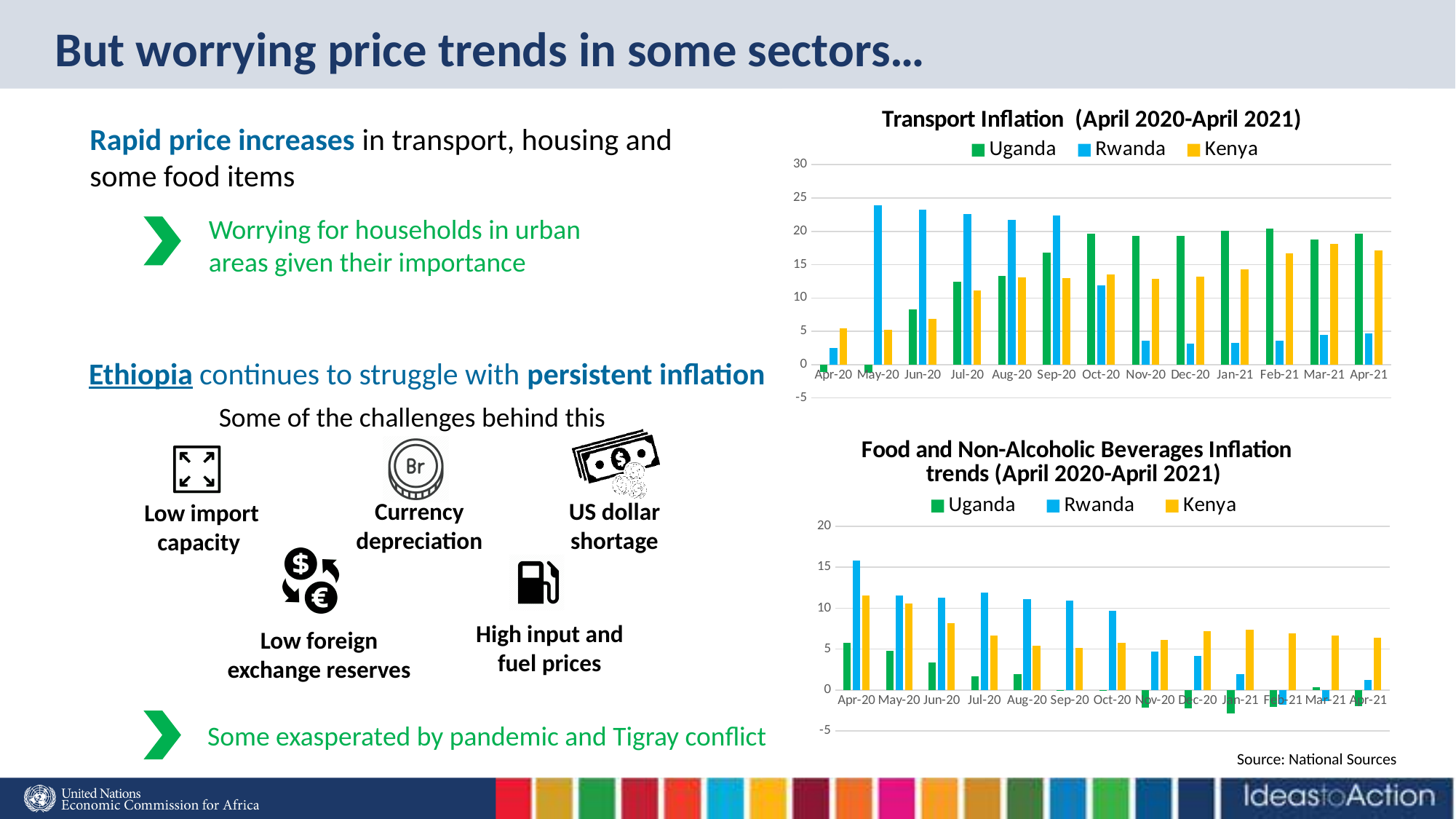
In the Transport Inflation chart, which is larger in Apr-21: Uganda or Rwanda? Uganda What kind of chart is the Transport Inflation (April 2020-April 2021) chart? Bar chart In the Food and Non-Alcoholic Beverages Inflation trends chart, is the value for Rwanda in Apr-20 greater or less than 15? greater How many months are shown on the x axis of the Transport Inflation chart? 13 How many series does the legend of the Transport Inflation chart list? 3 In the Transport Inflation chart, is the value for Rwanda in May-20 greater or less than 20? greater In the Transport Inflation chart, does the Rwanda value rise or fall from Sep-20 to Oct-20? Fall In the Transport Inflation chart, which country has the highest bar in May-20? Rwanda In the Food and Non-Alcoholic Beverages Inflation trends chart, which is larger in Apr-21: Kenya or Rwanda? Kenya In the Transport Inflation chart, is the value for Kenya in Apr-21 greater or less than 15? greater In the Food and Non-Alcoholic Beverages Inflation trends chart, what colour represents Kenya in the legend? Yellow How many series does the legend of the Food and Non-Alcoholic Beverages Inflation trends chart list? 3